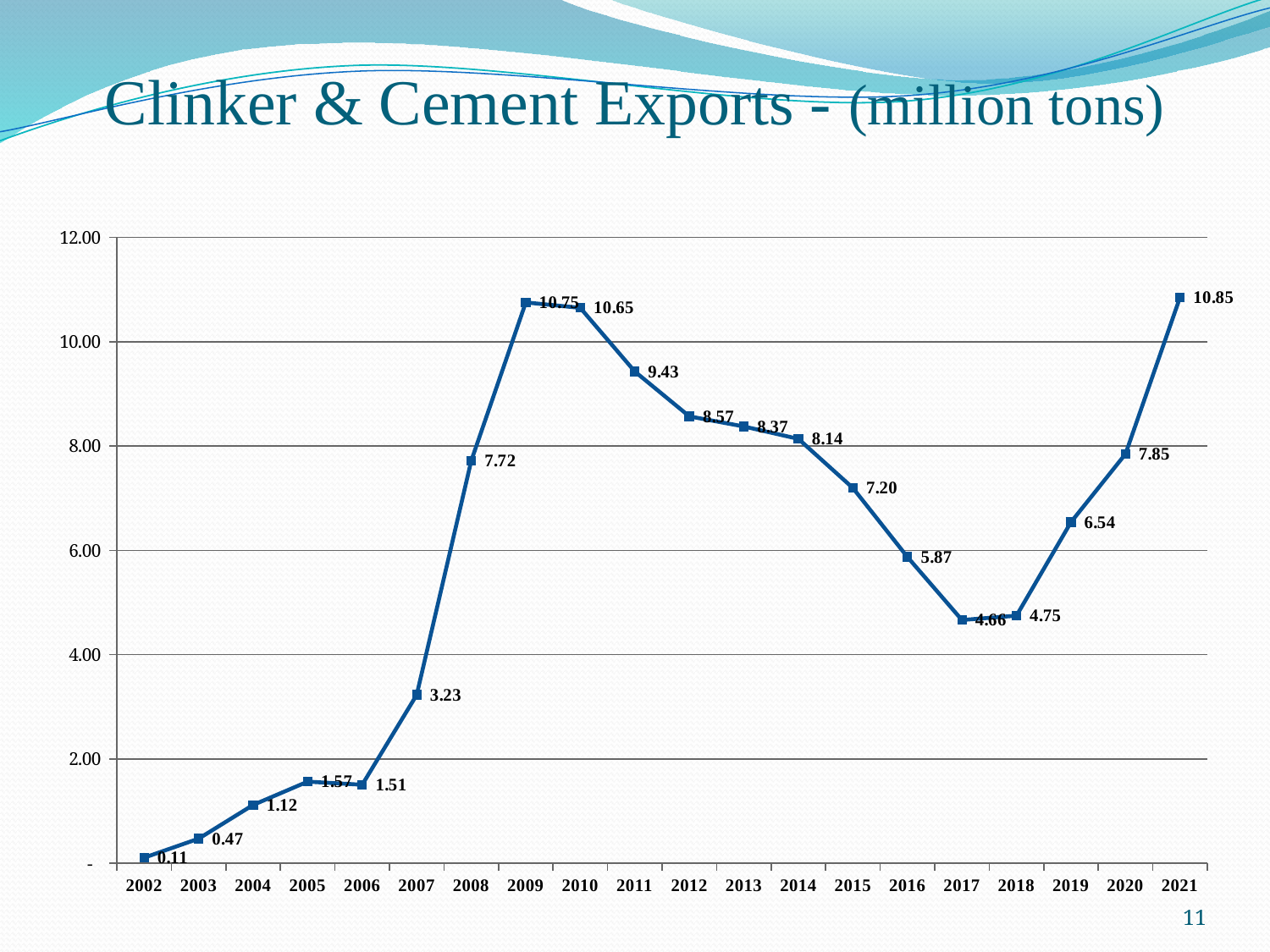
Which year had higher exports, 2011 or 2019? 2011 What is the difference between the export values for 2009 and 2017? 6.09 Which year has the highest value of clinker and cement exports? 2021 Is the value for 2007 greater or less than 4.00? less Do the export values rise or fall from 2010 to 2017? Fall What kind of chart is shown on the slide? Line chart What was the value of clinker and cement exports in 2021? 10.85 What was the value of clinker and cement exports in 2008? 7.72 Which year has the lowest value of clinker and cement exports? 2002 How many years are plotted on the chart? 20 What is the title of the chart? Clinker & Cement Exports - (million tons) What was the value of clinker and cement exports in 2015? 7.20